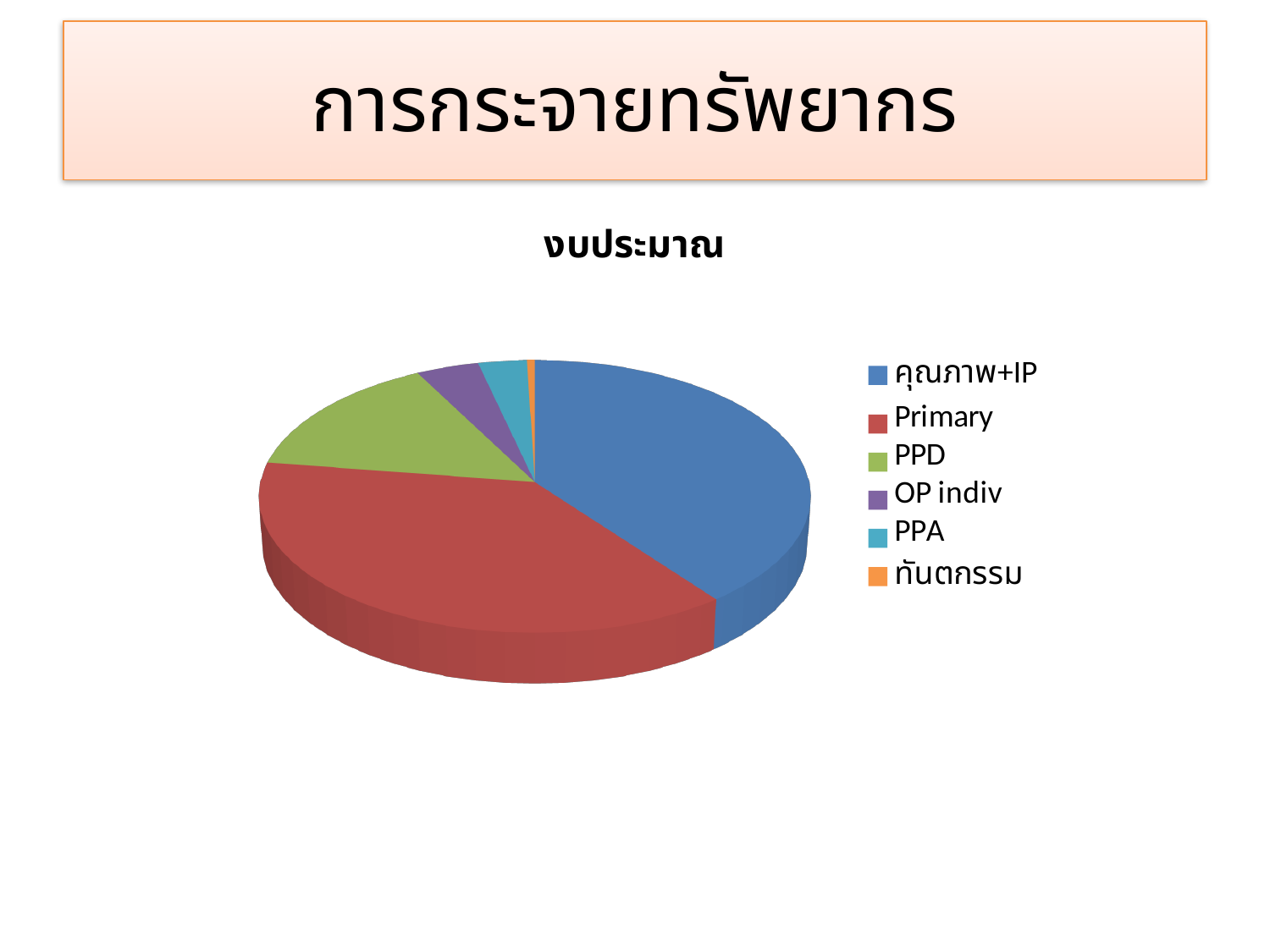
What kind of chart is shown on the slide? pie chart How many categories (slices) does the pie chart have? 6 How many entries does the legend list? 6 What is the title of the chart? งบประมาณ Which slice is larger, PPD or OP indiv? PPD Which category has the smallest slice of the pie? ทันตกรรม What colour is the Primary slice in the pie chart? red Which slice is larger, คุณภาพ+IP or PPD? คุณภาพ+IP Which slice is larger, PPA or ทันตกรรม? PPA